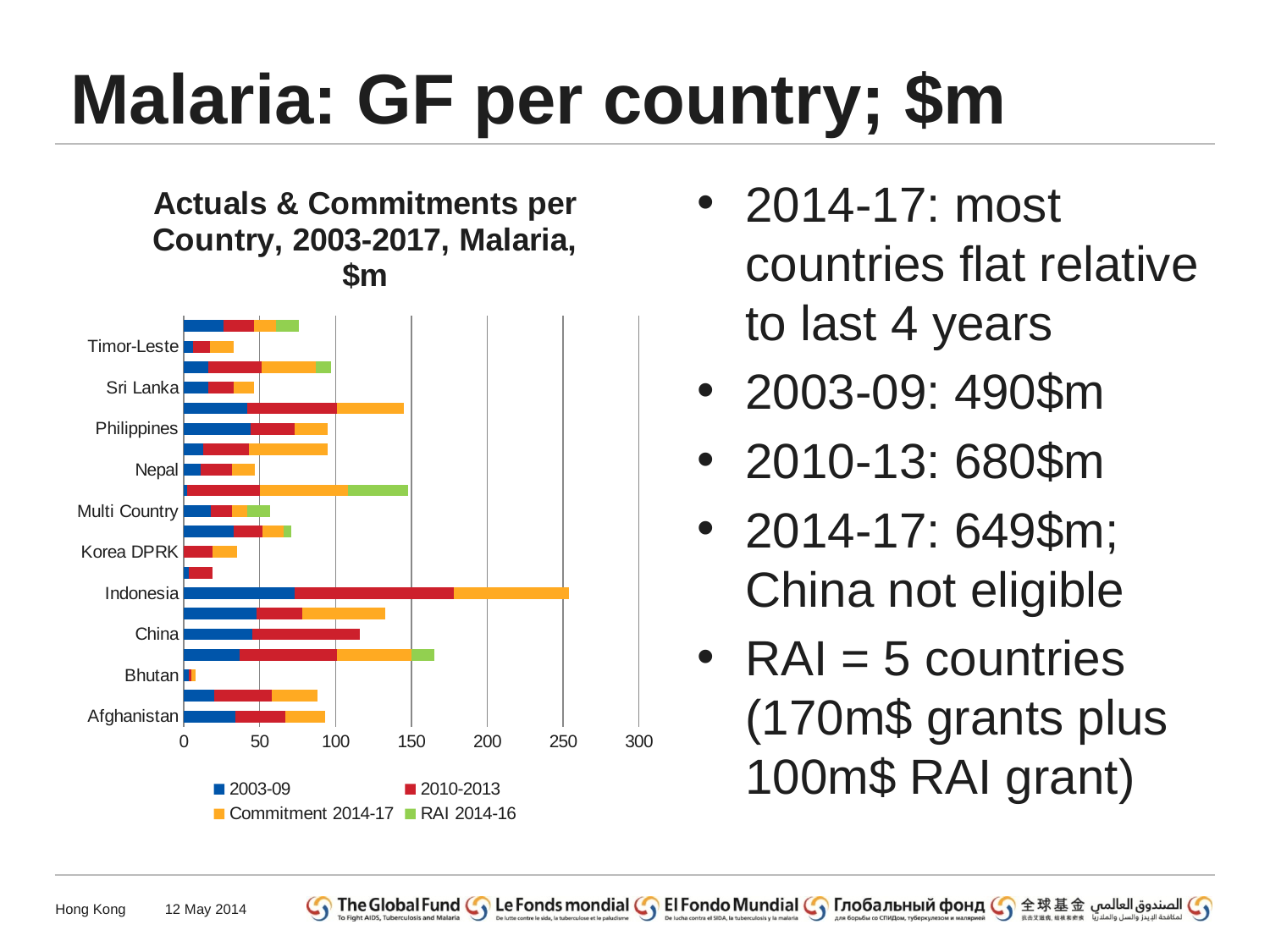
Is the total bar for Korea DPRK greater or less than 50? less Which has the larger total bar, Afghanistan or Bhutan? Afghanistan What kind of chart is shown on the slide? bar chart Which labelled country has the longest total bar in the chart? Indonesia Is the total bar for Bhutan greater or less than 50? less How many series does the chart legend list? 4 Which labelled country has the shortest total bar in the chart? Bhutan Is the total bar for Indonesia greater or less than 200? greater Which has the larger total bar, Indonesia or China? Indonesia Which series in the legend is shown in green? RAI 2014-16